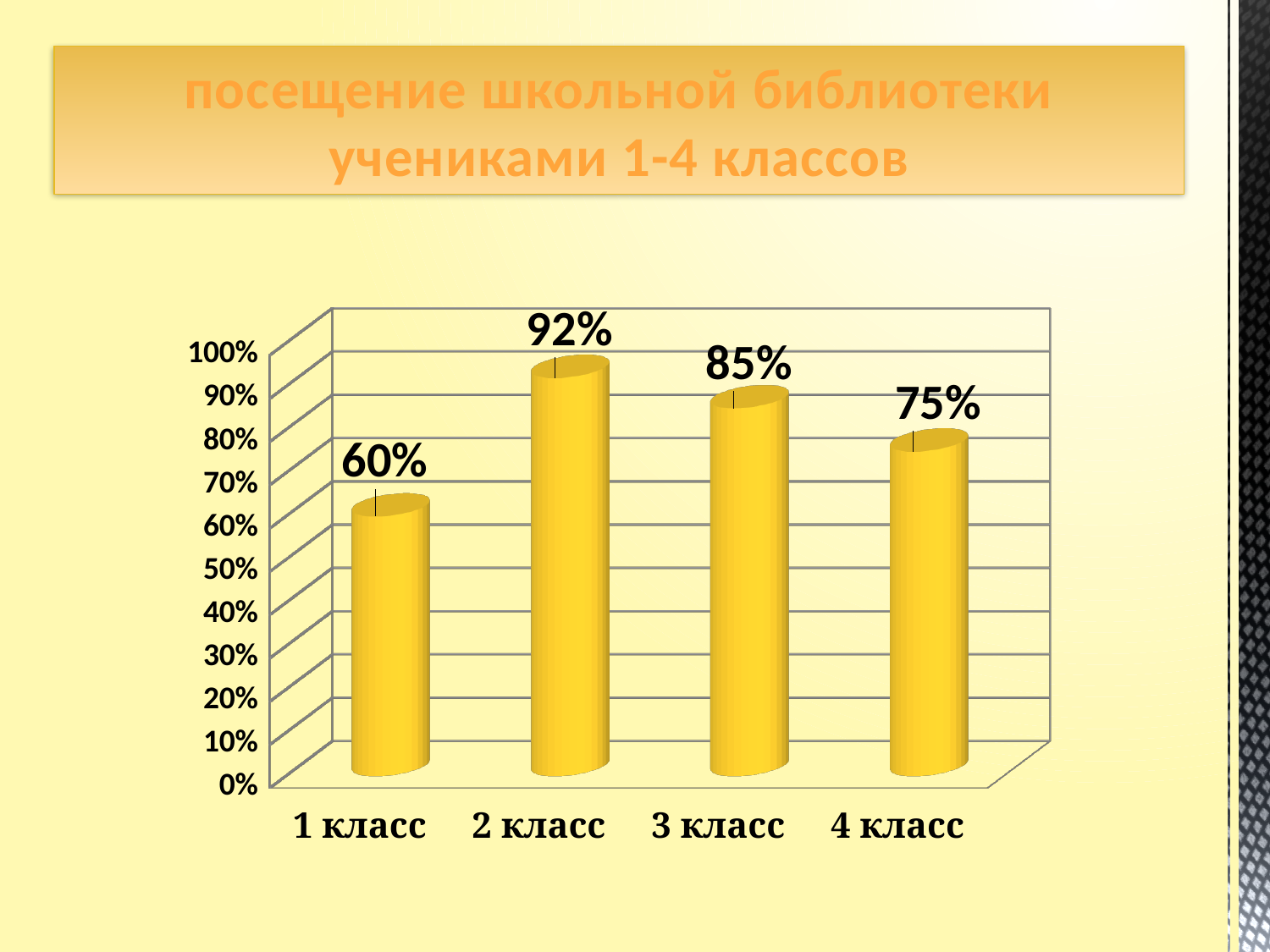
What is the difference between the values for 2 класс and 1 класс? 32% What is the value for 3 класс? 85% Which is larger, the value for 3 класс or the value for 4 класс? 3 класс What is the value for 4 класс? 75% Which class has the lowest value? 1 класс What is the value for 1 класс? 60% Which class has the highest value? 2 класс What is the value for 2 класс? 92% What is the title of the slide? посещение школьной библиотеки учениками 1-4 классов How many categories are shown on the x axis? 4 What is the difference between the values for 3 класс and 4 класс? 10% What kind of chart is shown on the slide? bar chart